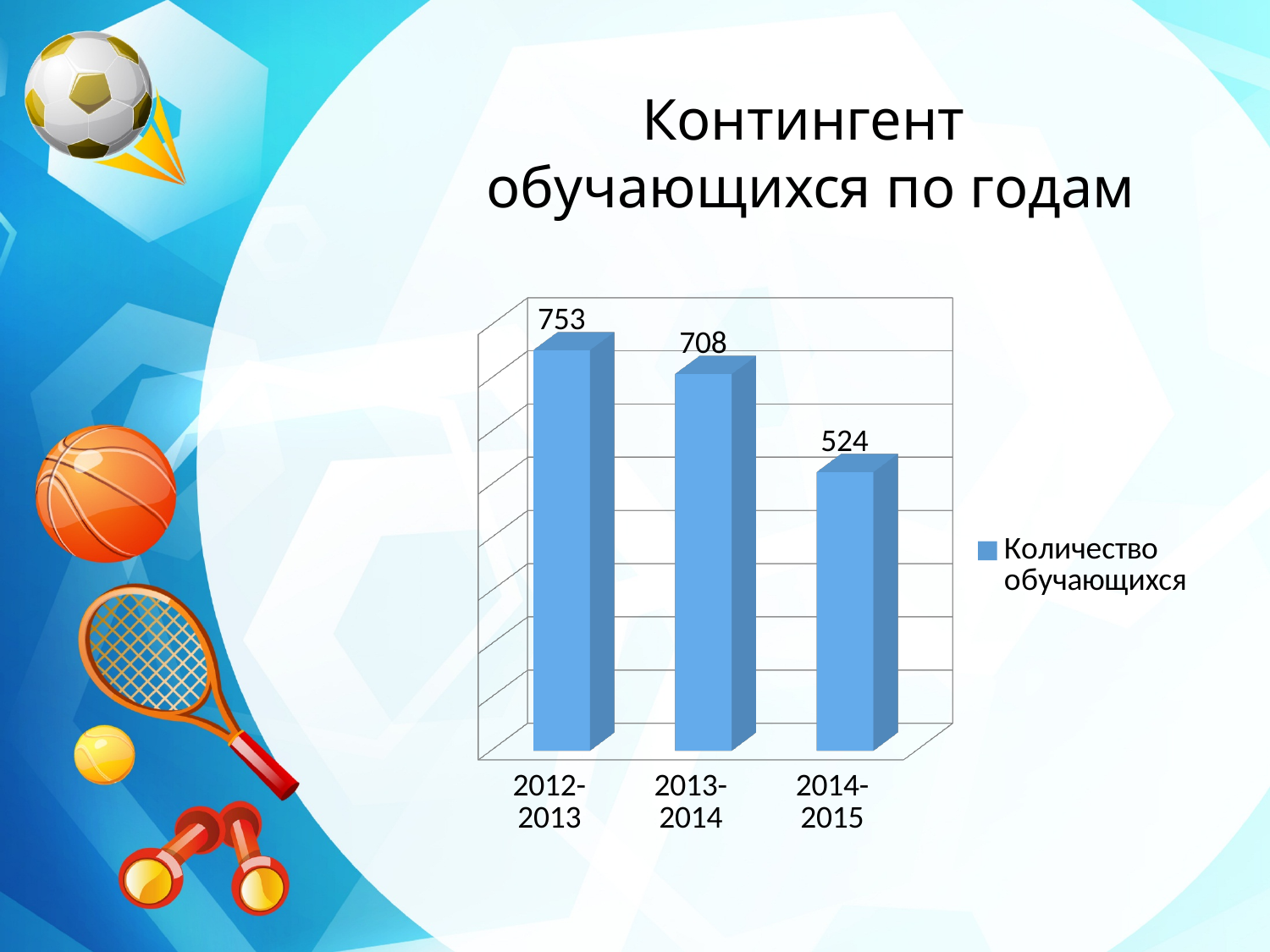
What kind of chart is shown on the slide? bar chart What is the value for 2014-2015? 524 Which year has the highest number of students? 2012-2013 What is the value for 2013-2014? 708 What is the difference between the values for 2012-2013 and 2013-2014? 45 Which year has the lowest number of students? 2014-2015 How many categories are shown on the x axis? 3 How many series does the legend list? 1 What is the difference between the values for 2012-2013 and 2014-2015? 229 What is the value for 2012-2013? 753 Which is larger, the value for 2013-2014 or the value for 2014-2015? 2013-2014 Do the values rise or fall from 2012-2013 to 2014-2015? fall